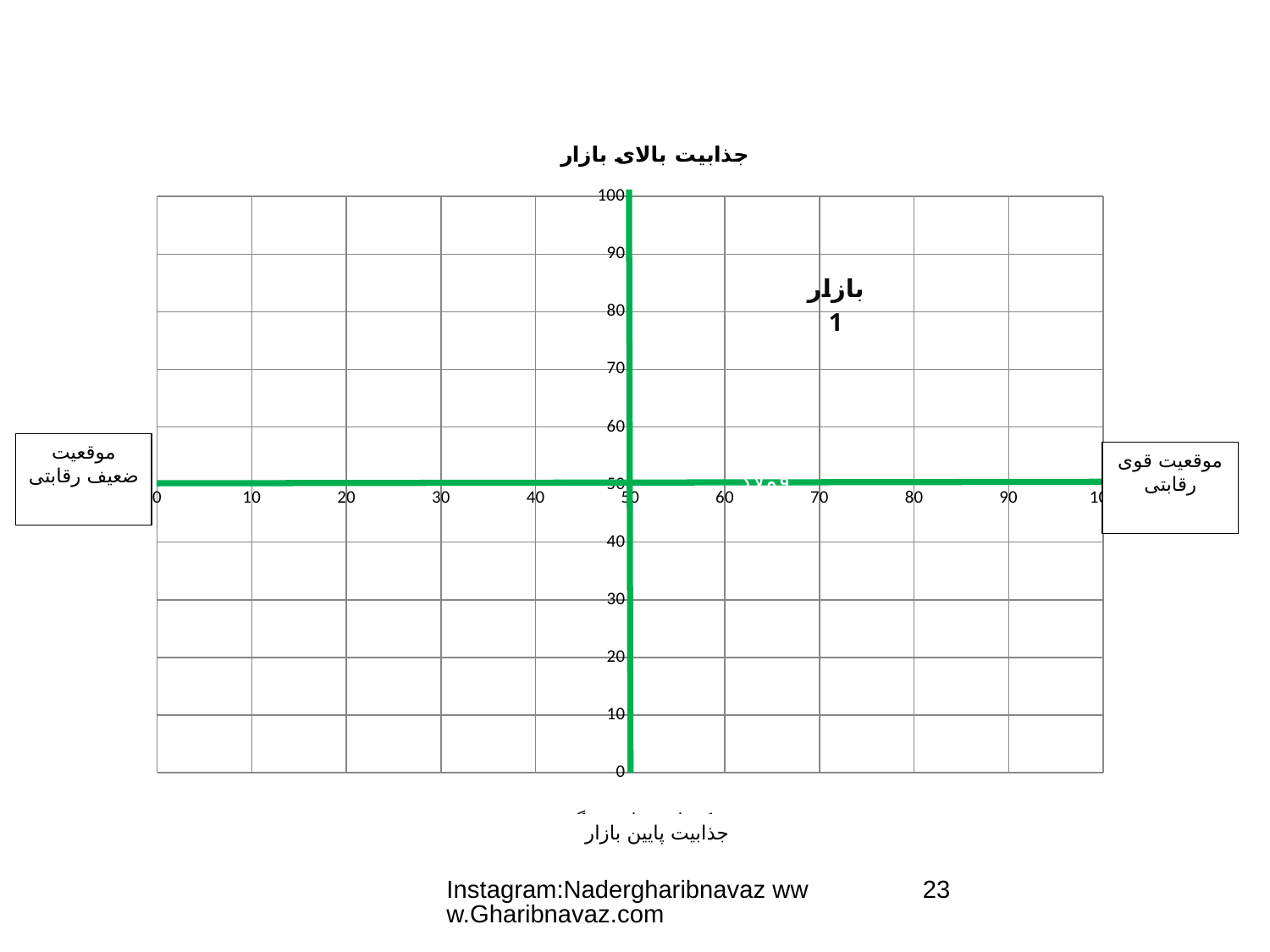
At what value on the vertical axis does the thick green horizontal line cross? 50 What kind of chart is shown on the slide? scatter chart What is the interval between consecutive tick labels on the vertical axis? 10 How many tick labels are printed on the vertical axis? 11 At what value on the horizontal axis does the thick green vertical line cross? 50 Is the vertical position of the label بازار 1 greater or less than 90? less How many labeled data points (markets) are shown on the chart? 1 What is the maximum value shown on the vertical axis? 100 Is the vertical position of the label بازار 1 greater or less than 50? greater Is the horizontal position of the label بازار 1 greater or less than 50? greater